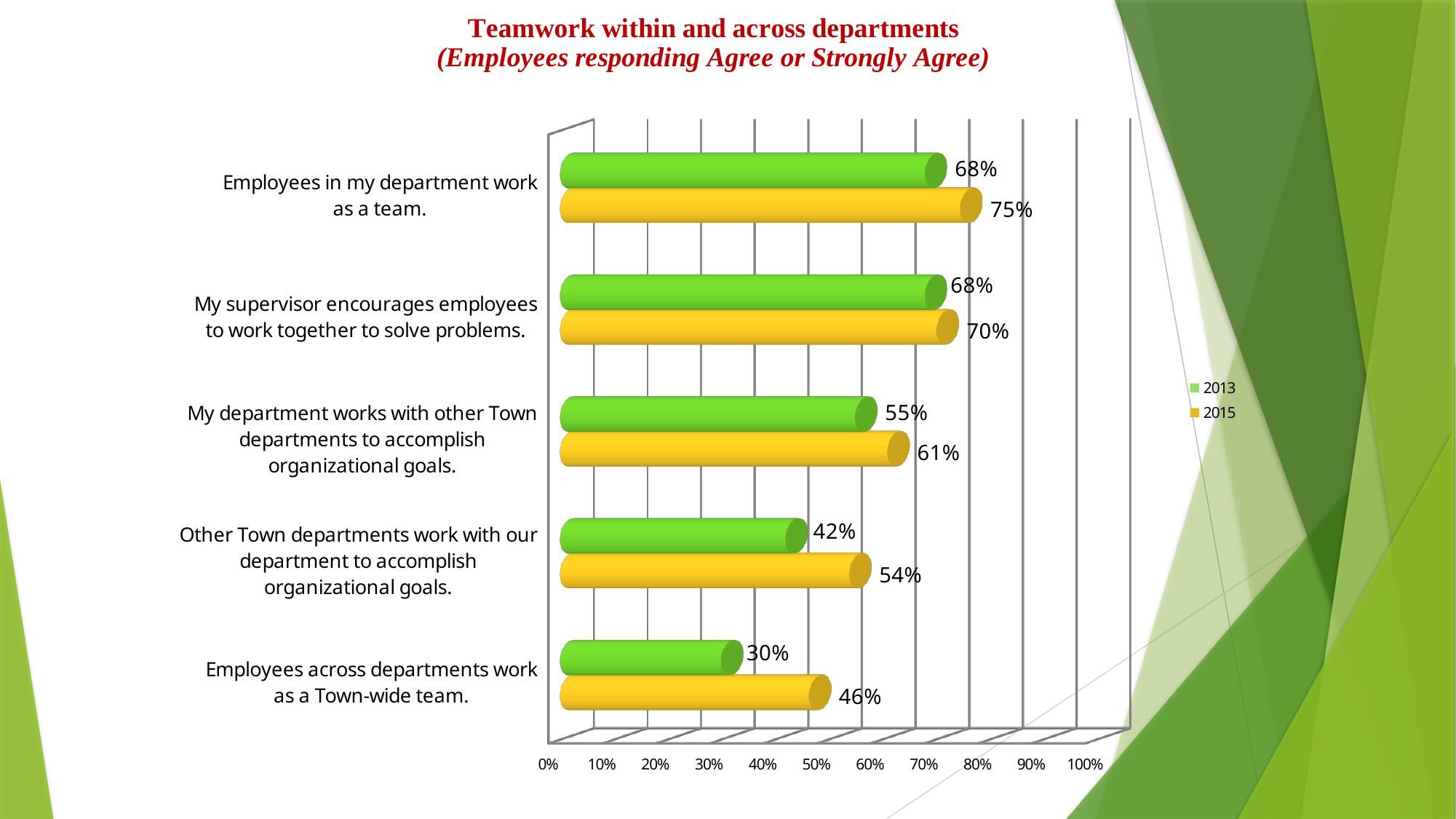
What is the difference between the 2013 and 2015 values for "My department works with other Town departments to accomplish organizational goals"? 6 percentage points How many statements (categories) are shown in the chart? 5 For "My supervisor encourages employees to work together to solve problems", which year had the higher value, 2013 or 2015? 2015 What percentage of employees agreed in 2015 that employees in their department work as a team? 75% What type of chart is shown on the slide? Bar chart How many series does the legend list? 2 Which statement had the lowest 2013 value? Employees across departments work as a Town-wide team. Which statement had the highest 2015 value? Employees in my department work as a team. Which years are listed in the chart legend? 2013 and 2015 What was the 2013 value for "Employees across departments work as a Town-wide team"? 30% By how many percentage points did the value for "Employees across departments work as a Town-wide team" change from 2013 to 2015? 16 percentage points What was the 2015 value for "Other Town departments work with our department to accomplish organizational goals"? 54%